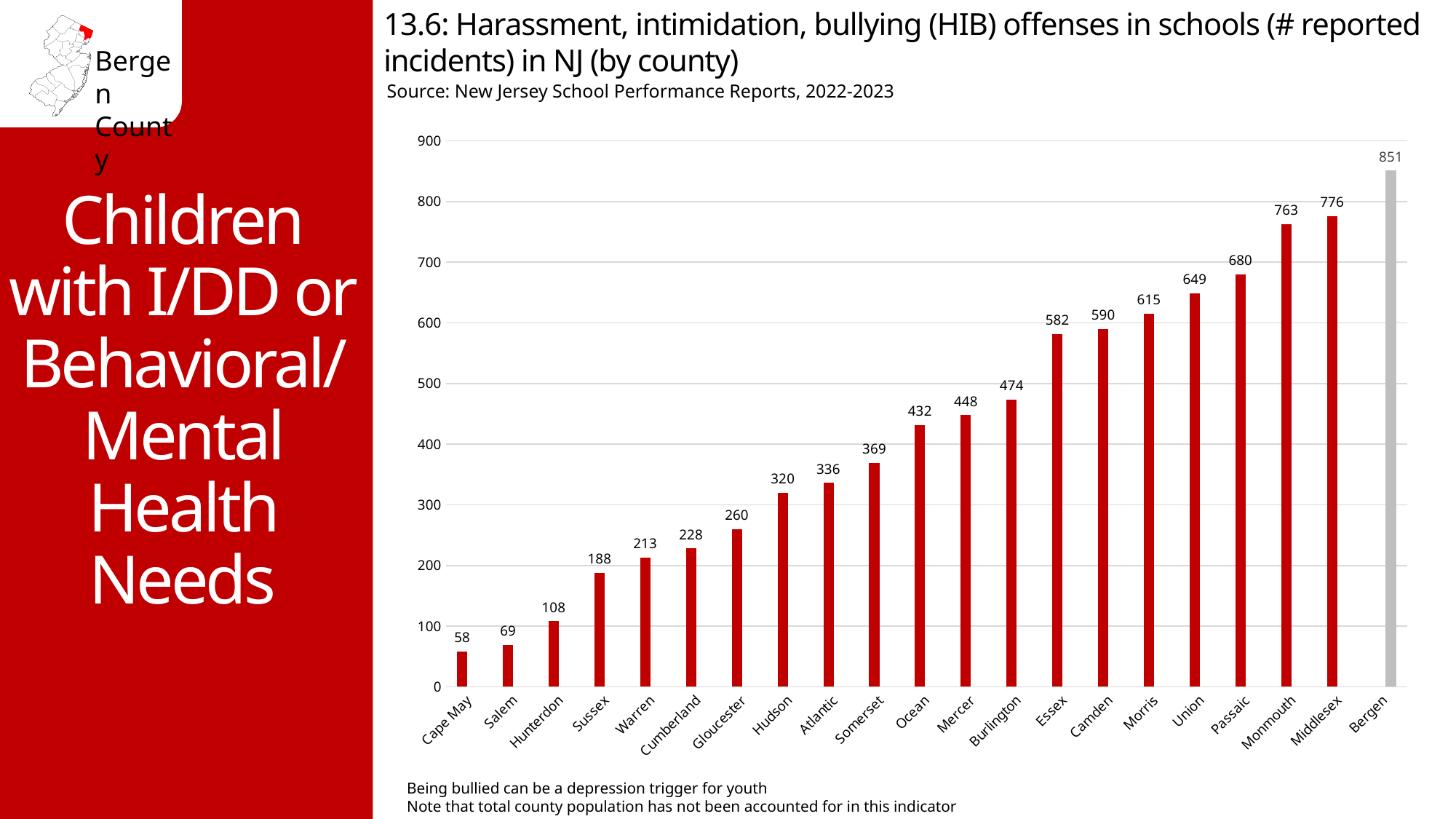
How many counties are shown on the chart? 21 Which county has the highest number of reported HIB incidents? Bergen What is the number of reported HIB incidents for Bergen County? 851 What is the difference in reported HIB incidents between Bergen and Middlesex? 75 What is the number of reported HIB incidents for Hudson County? 320 Which county has the lowest number of reported HIB incidents? Cape May What is the difference in reported HIB incidents between Monmouth and Ocean? 331 What kind of chart is used to show HIB incidents by county? Bar chart Which county has more reported HIB incidents, Camden or Burlington? Camden Do the values rise or fall moving from left to right along the x axis? Rise Is the value for Passaic greater or less than 600? greater What is the number of reported HIB incidents for Essex County? 582